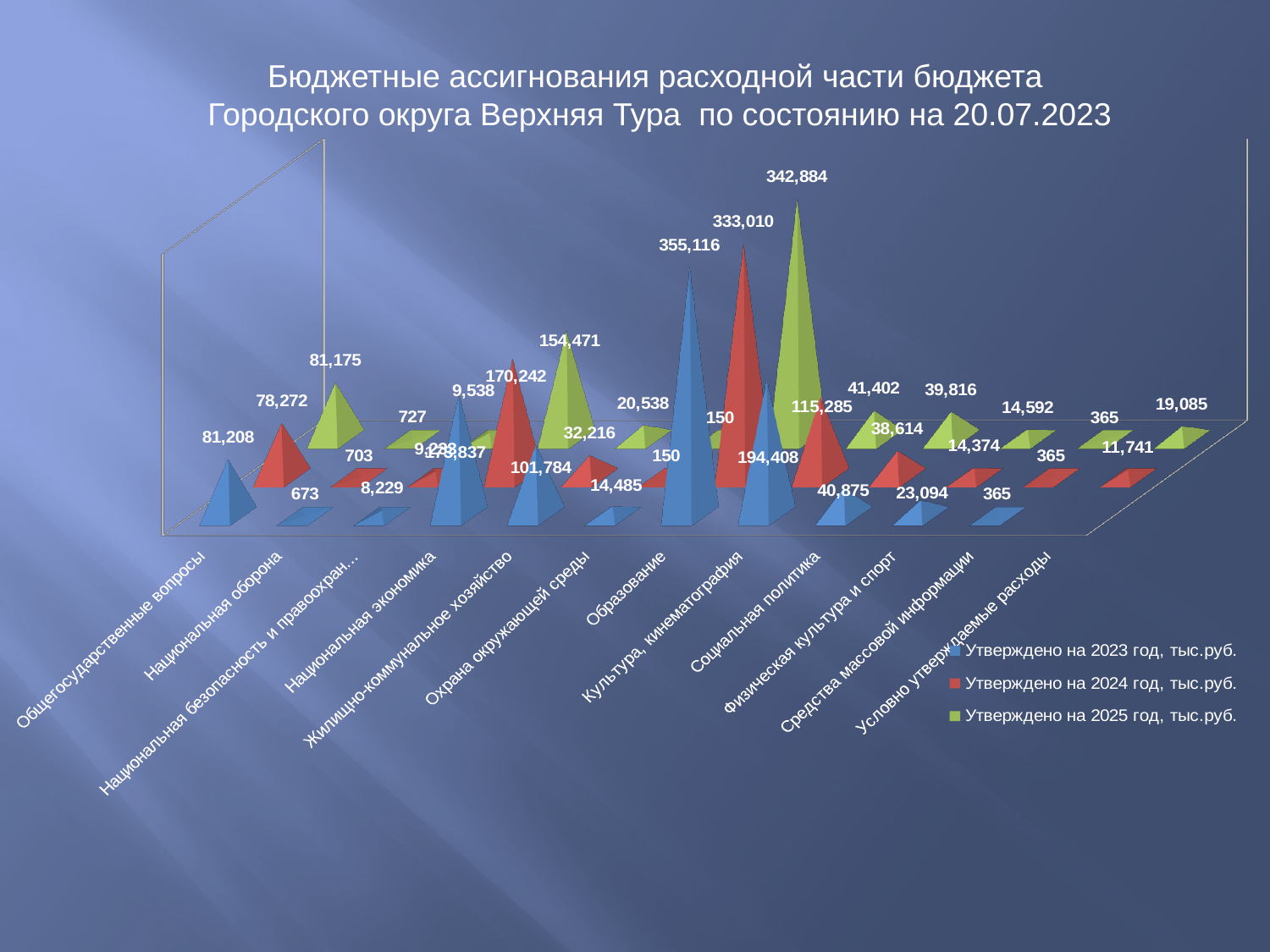
Which colour represents the series 'Утверждено на 2025 год, тыс.руб.'? green What is the difference between the 2023 and 2024 values for Образование? 22,106 What is the value for Образование in the series 'Утверждено на 2025 год, тыс.руб.'? 342,884 What is the value for Общегосударственные вопросы in the series 'Утверждено на 2024 год, тыс.руб.'? 78,272 What is the difference between the 2025 and 2023 values for Национальная оборона? 54 Which category has the highest value in the series 'Утверждено на 2023 год, тыс.руб.'? Образование What is the value for Образование in the series 'Утверждено на 2023 год, тыс.руб.'? 355,116 How many categories are shown along the x axis? 12 Which is larger for Образование: the 2023 value or the 2025 value? 2023 value What is the value for Национальная экономика in the series 'Утверждено на 2024 год, тыс.руб.'? 170,242 How many series does the legend list? 3 What kind of chart is shown on the slide? bar chart